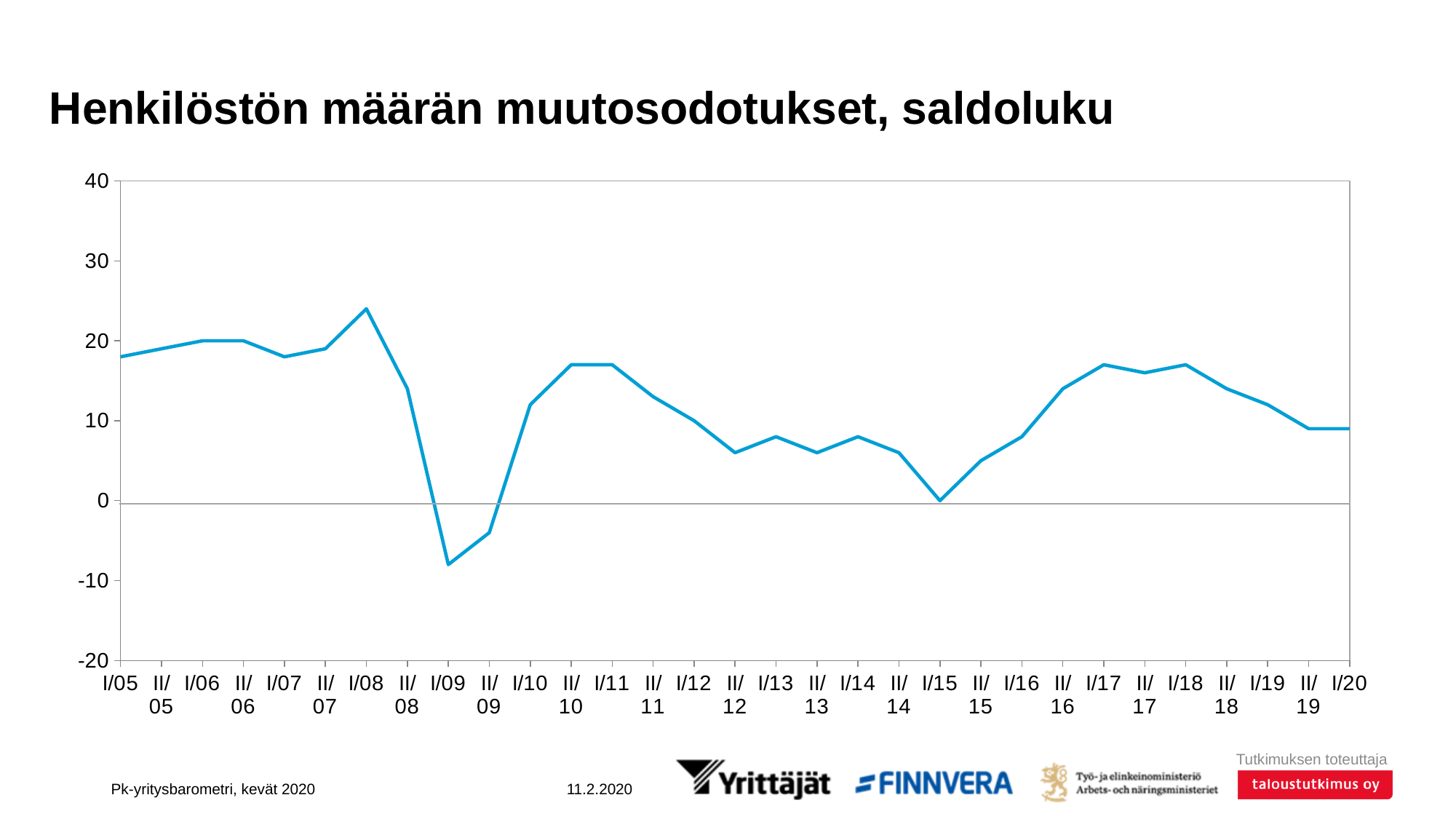
Is the value for I/08 greater or less than 20? greater How many data points are plotted on the line? 31 At which period does the line reach its lowest value? I/09 What is the title of the chart? Henkilöstön määrän muutosodotukset, saldoluku Which is larger, the value for I/11 or the value for I/13? I/11 Is the value for I/17 greater or less than 10? greater Do the values rise or fall from I/18 to I/20? fall What kind of chart is shown on the slide? line chart Is the value for I/20 greater or less than 10? less What is the value for I/15? 0 At which period does the line reach its highest value? I/08